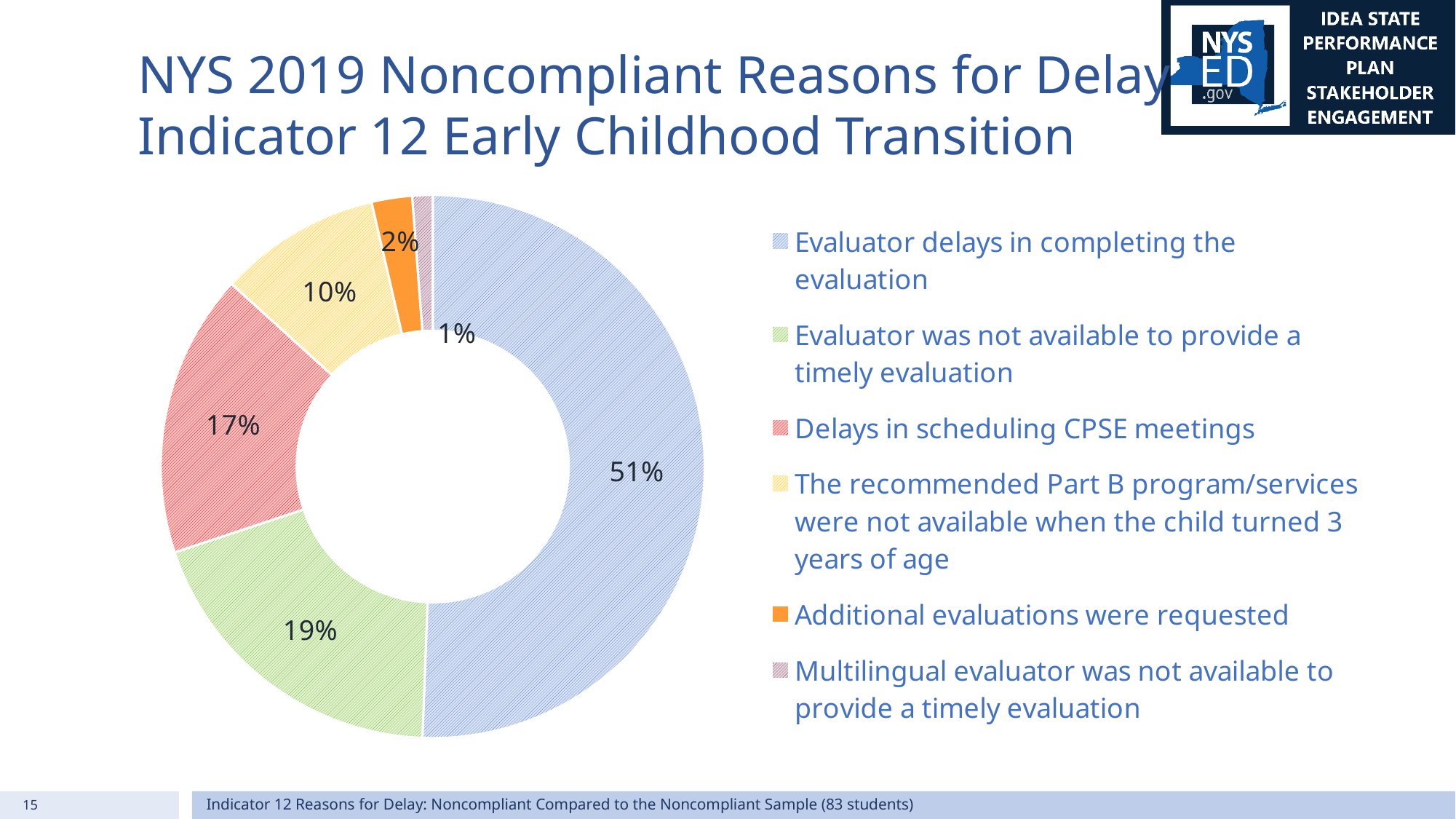
What colour is the slice for 'Additional evaluations were requested'? Orange What kind of chart is shown on the slide? Pie chart (doughnut) How many reasons for delay are shown in the chart? 6 Which reason for delay has the largest share of the pie? Evaluator delays in completing the evaluation What share of the pie is 'Evaluator delays in completing the evaluation'? 51% What is the difference in percentage points between 'Evaluator was not available to provide a timely evaluation' and 'Delays in scheduling CPSE meetings'? 2 Which reason for delay has the smallest share of the pie? Multilingual evaluator was not available to provide a timely evaluation What share of the pie is 'Additional evaluations were requested'? 2% Which is larger: the share for 'The recommended Part B program/services were not available when the child turned 3 years of age' or the share for 'Additional evaluations were requested'? The recommended Part B program/services were not available when the child turned 3 years of age What share of the pie is 'Multilingual evaluator was not available to provide a timely evaluation'? 1% What share of the pie is 'Evaluator was not available to provide a timely evaluation'? 19% What share of the pie is 'Delays in scheduling CPSE meetings'? 17%